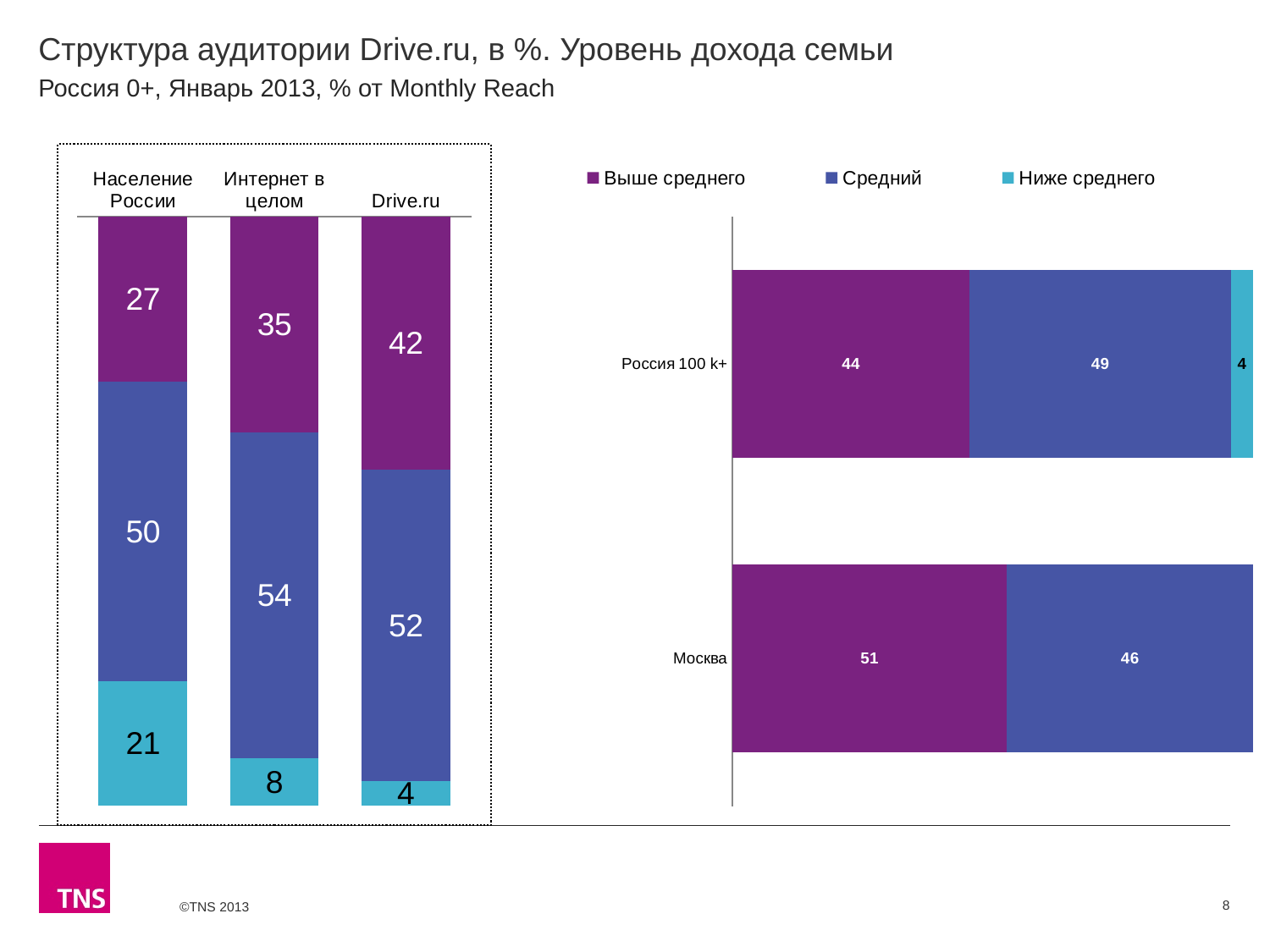
What type of chart is the right chart? Stacked bar chart In the left chart, what is the value of the 'Средний' segment for Интернет в целом? 54 In the left chart, what is the value of the 'Выше среднего' segment for Drive.ru? 42 In the left chart, what is the value of the 'Ниже среднего' segment for Население России? 21 In the left chart, what is the difference between the 'Выше среднего' values for Drive.ru and Население России? 15 In the right chart, what is the 'Выше среднего' value for Москва? 51 How many series does the legend list? 3 In the right chart, what is the 'Средний' value for Россия 100 k+? 49 In the left chart, which category has the lowest 'Ниже среднего' value? Drive.ru In the right chart, which is larger: the 'Выше среднего' value for Москва or for Россия 100 k+? Москва In the left chart, which category has the highest 'Выше среднего' value? Drive.ru In the left chart, how many categories are shown on the x axis? 3